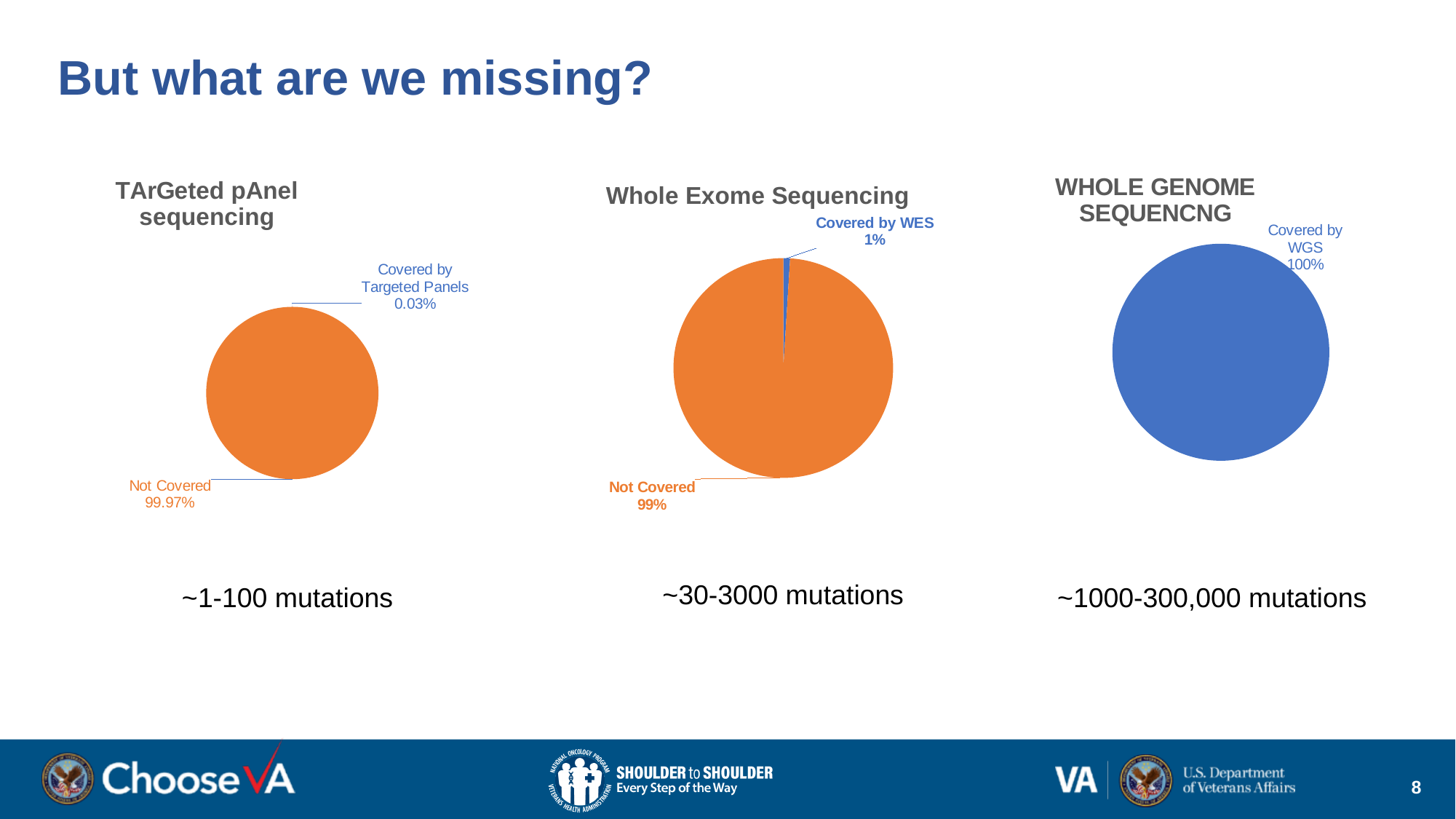
In the "TArGeted pAnel sequencing" chart, what share is labelled "Covered by Targeted Panels"? 0.03% In the "TArGeted pAnel sequencing" chart, which slice is the smallest? Covered by Targeted Panels How many pie charts are shown on the slide? 3 In the "Whole Exome Sequencing" chart, which slice is the largest? Not Covered In the "WHOLE GENOME SEQUENCNG" chart, what share is labelled "Covered by WGS"? 100% What kind of chart is the "Whole Exome Sequencing" chart? pie chart What colour is the "Not Covered" slice in the "Whole Exome Sequencing" chart? orange In the "Whole Exome Sequencing" chart, what is the difference between the "Not Covered" share and the "Covered by WES" share? 98% In the "Whole Exome Sequencing" chart, what share is labelled "Not Covered"? 99% In the "Whole Exome Sequencing" chart, what share is labelled "Covered by WES"? 1% In the "TArGeted pAnel sequencing" chart, which is larger: "Not Covered" or "Covered by Targeted Panels"? Not Covered In the "TArGeted pAnel sequencing" chart, what share is labelled "Not Covered"? 99.97%